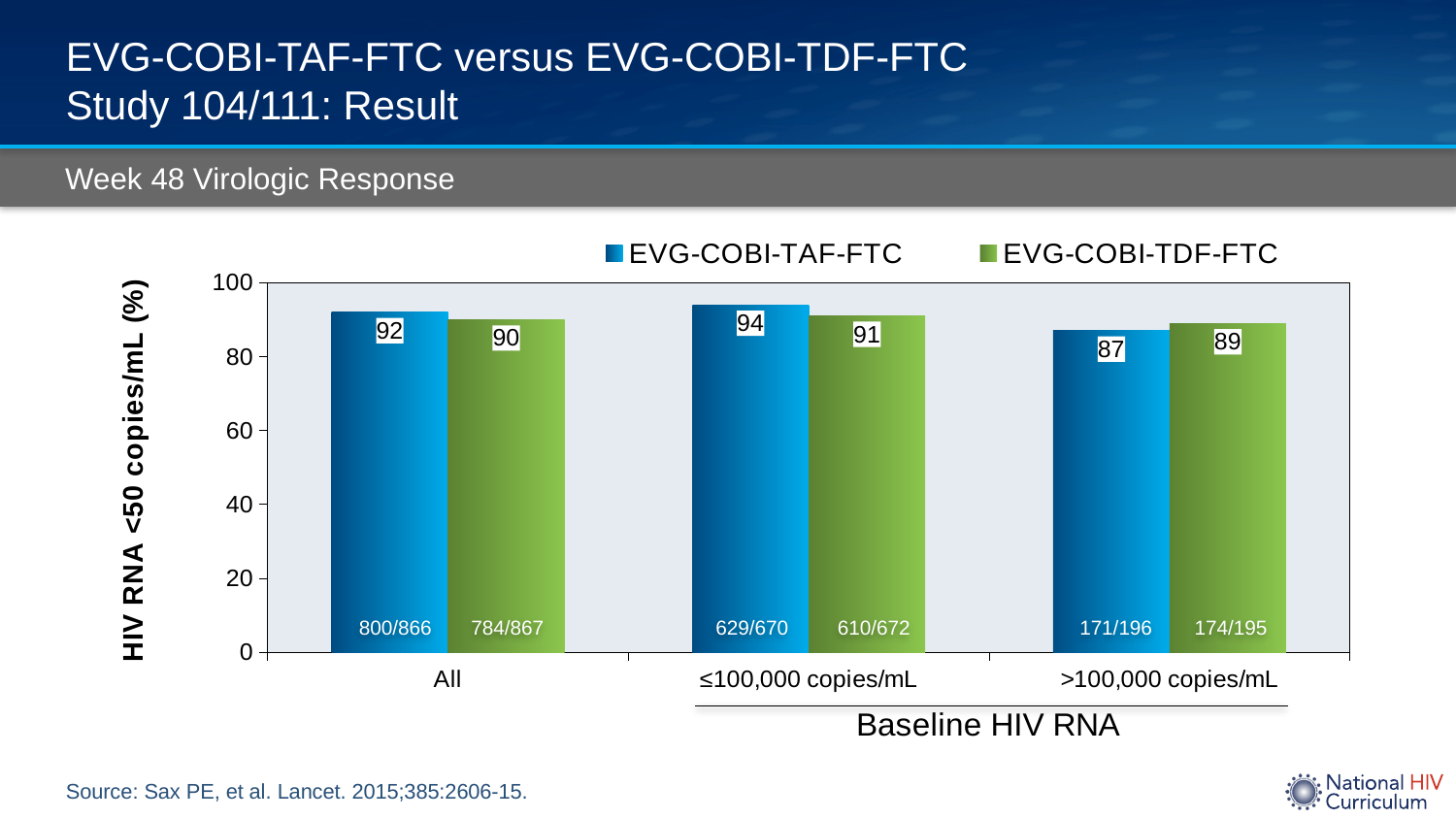
Is the value for EVG-COBI-TAF-FTC in the All category greater or less than 80? greater What is the y-axis label of the chart? HIV RNA <50 copies/mL (%) Which category has the highest value for EVG-COBI-TAF-FTC? ≤100,000 copies/mL What is the value for EVG-COBI-TDF-FTC in the >100,000 copies/mL category? 89 What is the value for EVG-COBI-TDF-FTC in the ≤100,000 copies/mL category? 91 How many series does the legend list? 2 In the >100,000 copies/mL category, which series has the larger value, EVG-COBI-TAF-FTC or EVG-COBI-TDF-FTC? EVG-COBI-TDF-FTC Which category has the lowest value for EVG-COBI-TAF-FTC? >100,000 copies/mL What is the difference between EVG-COBI-TAF-FTC and EVG-COBI-TDF-FTC in the ≤100,000 copies/mL category? 3 What is the value for EVG-COBI-TAF-FTC in the All category? 92 What kind of chart is shown on the slide? Bar chart How many categories are shown on the x axis? 3